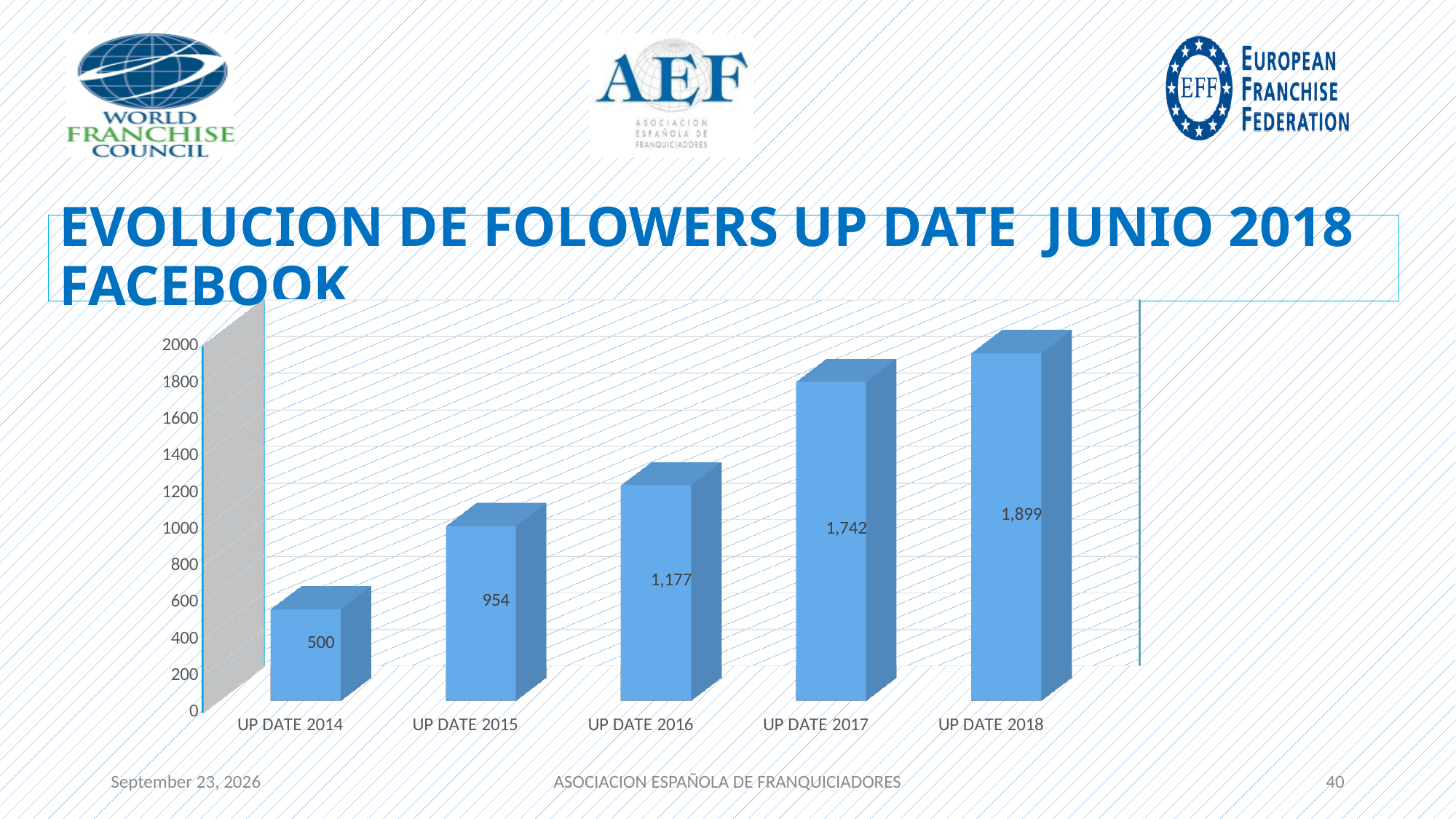
How many categories are shown on the x axis? 5 Do the values rise or fall from UP DATE 2014 to UP DATE 2018? rise Which category has the highest value? UP DATE 2018 What is the difference between the values for UP DATE 2015 and UP DATE 2014? 454 Which is larger, the value for UP DATE 2016 or the value for UP DATE 2015? UP DATE 2016 What is the difference between the values for UP DATE 2018 and UP DATE 2017? 157 What is the value for UP DATE 2016? 1,177 Is the value for UP DATE 2017 greater or less than 1600? greater Which category has the lowest value? UP DATE 2014 What is the value for UP DATE 2014? 500 What is the value for UP DATE 2018? 1,899 What kind of chart is shown on the slide? bar chart